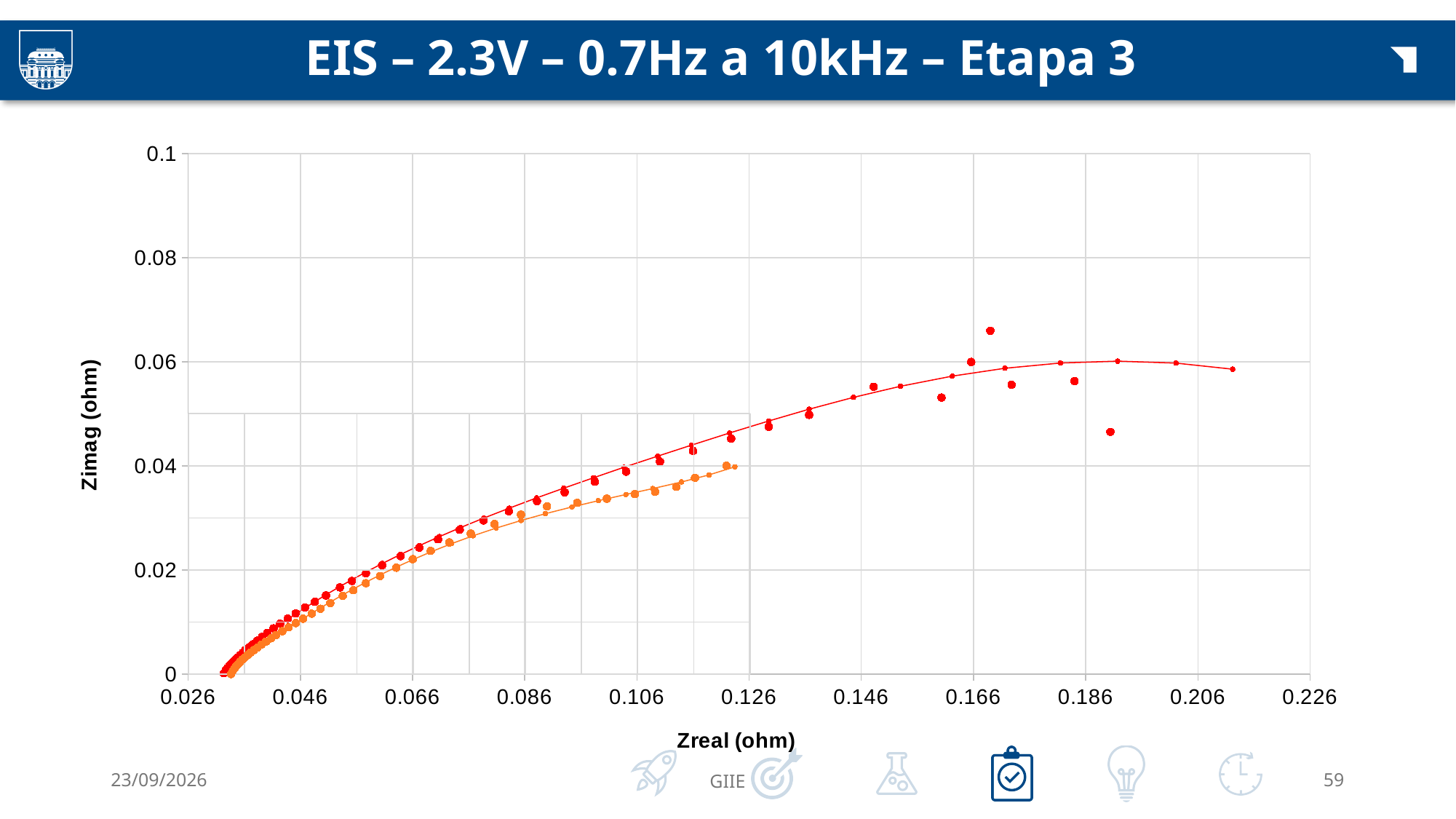
Is the highest Zimag value reached by the red series greater or less than 0.06? greater Which series reaches the higher maximum Zimag value, the red series or the orange series? red series What is the title of the horizontal axis of the chart? Zreal (ohm) Which series extends to larger Zreal values, the red series or the orange series? red series Is the Zimag value of the red series at Zreal 0.146 greater or less than 0.04? greater Is the largest Zreal value reached by the red series greater or less than 0.206? greater What is the title of the vertical axis of the chart? Zimag (ohm) What kind of chart is shown on the slide? scatter chart Do the Zimag values of the red series generally rise or fall as Zreal increases from 0.026 to about 0.186? rise